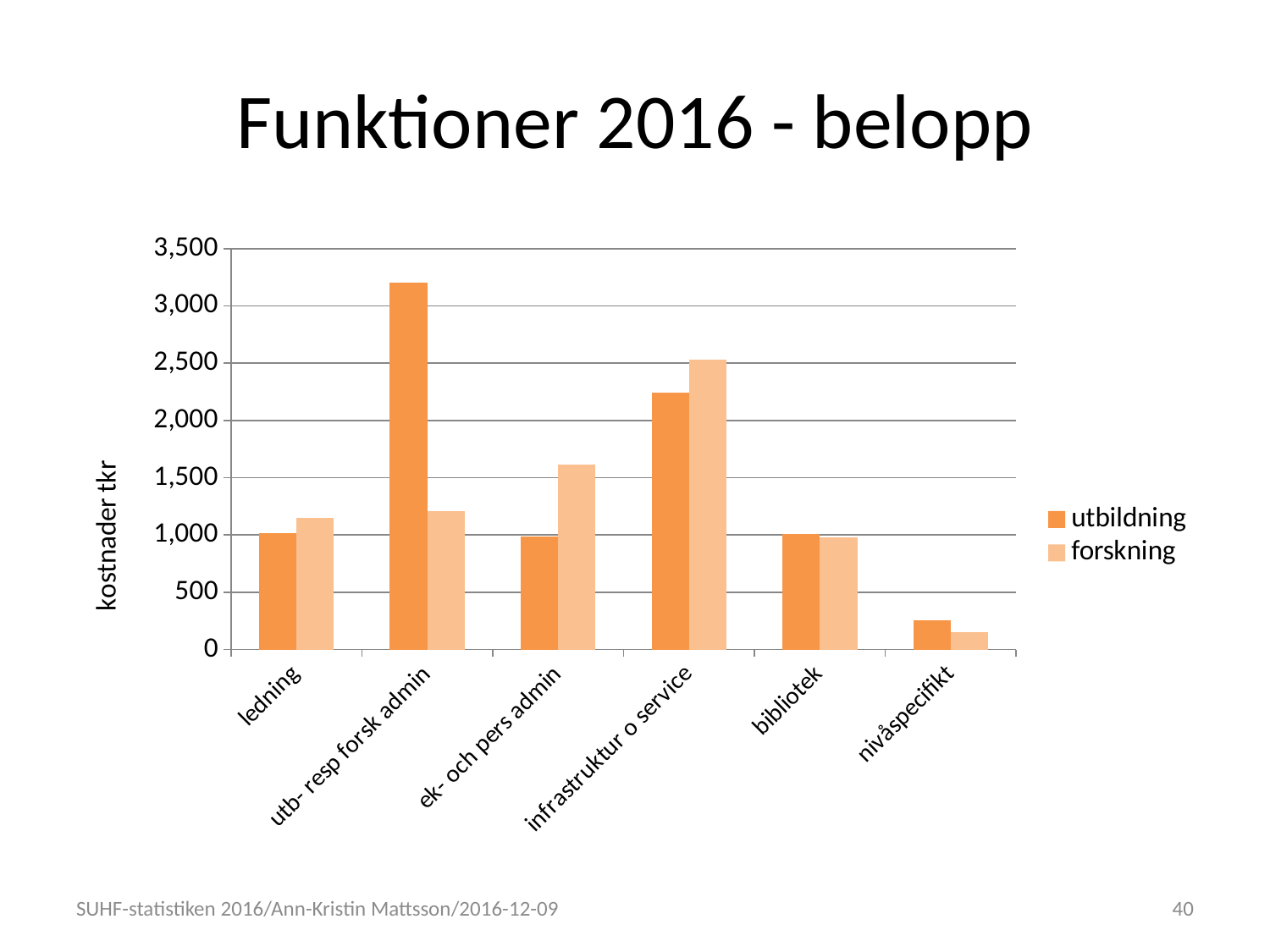
What kind of chart is shown on the slide? bar chart How many categories are shown on the x axis? 6 Which category has the lowest forskning value? nivåspecifikt Is the utbildning value for utb- resp forsk admin greater or less than 3,000? greater Is the forskning value for ek- och pers admin greater or less than 1,500? greater Which category has the highest forskning value? infrastruktur o service Which category has the lowest utbildning value? nivåspecifikt For ek- och pers admin, which is larger: utbildning or forskning? forskning What is the label of the y axis? kostnader tkr Which category has the highest utbildning value? utb- resp forsk admin How many series does the legend list? 2 Is the utbildning value for nivåspecifikt greater or less than 500? less